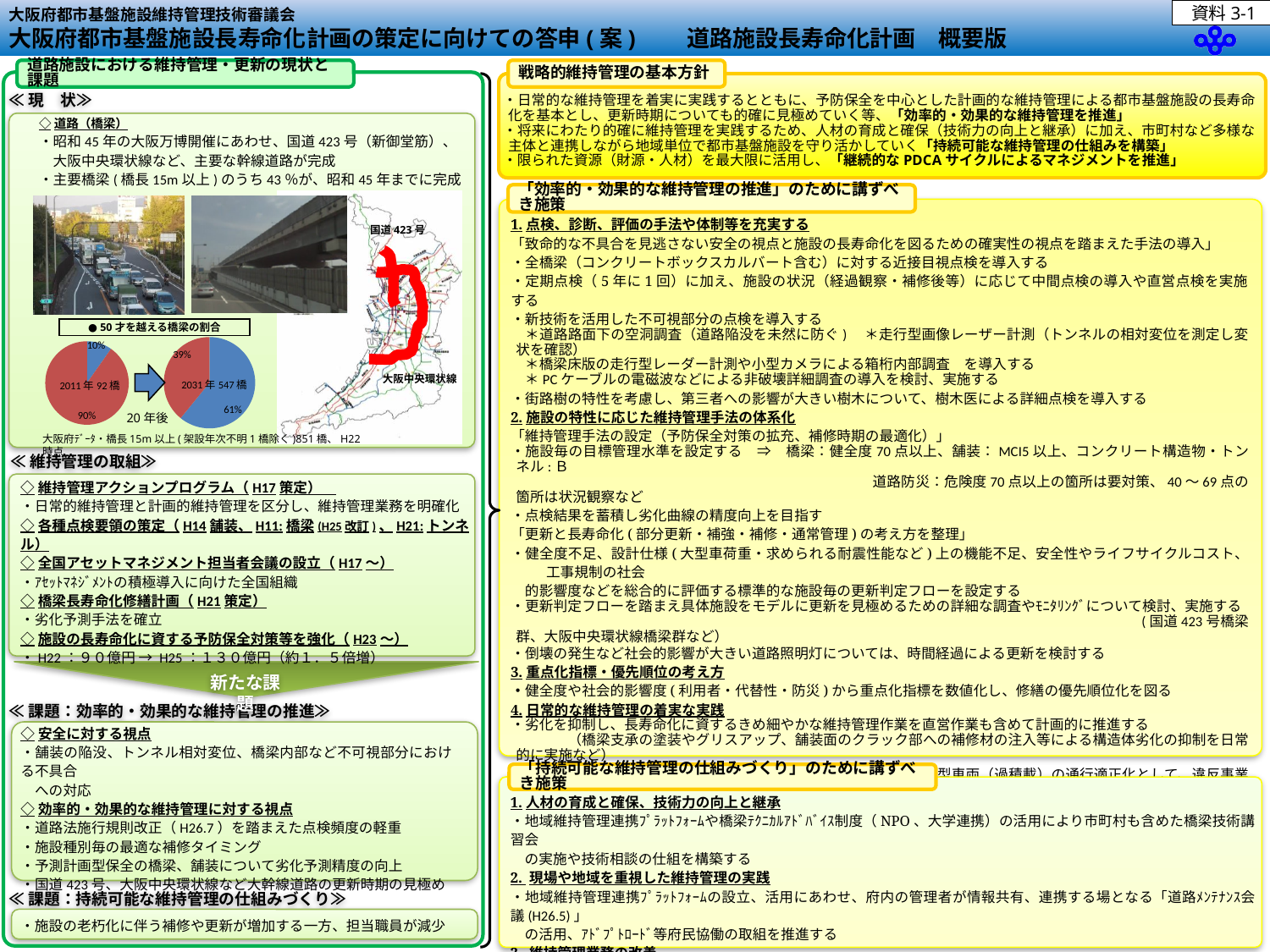
What kind of charts are shown under the heading ●50才を越える橋梁の割合? Pie charts In the left pie chart (2011年), what is the difference in percentage points between the two slices? 80 percentage points What label is written next to the arrow between the two pie charts? 20年後 In the right pie chart labelled 2031年 547橋, what percentage is shown for the larger slice? 61% In the right pie chart (2031年), what is the difference in percentage points between the two slices? 22 percentage points How many slices does the right pie chart (2031年) have? 2 In the left pie chart labelled 2011年 92橋, what percentage is shown for the larger slice? 90% What is the title written above the two pie charts? ●50才を越える橋梁の割合 In the left pie chart labelled 2011年 92橋, what percentage is shown for the smaller slice? 10% Which is larger: the largest slice of the 2011年 pie chart or the largest slice of the 2031年 pie chart? The 2011年 pie chart (90%) How many slices does the left pie chart (2011年) have? 2 In the right pie chart labelled 2031年 547橋, what percentage is shown for the smaller slice? 39%